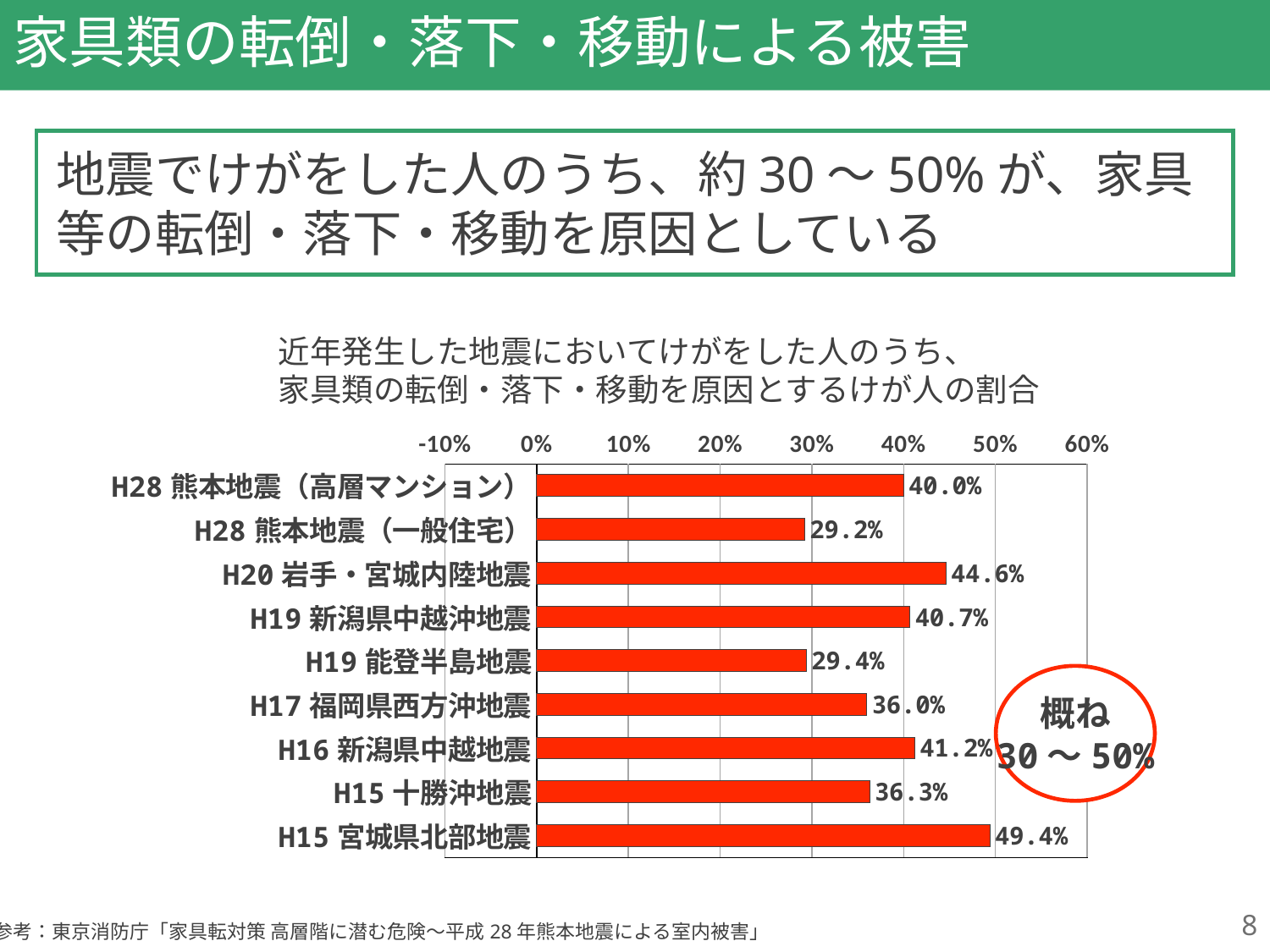
What is the difference between the values for H15 宮城県北部地震 and H28 熊本地震（一般住宅）? 20.2 percentage points Which is larger, the value for H16 新潟県中越地震 or the value for H19 新潟県中越沖地震? H16 新潟県中越地震 What is the value for H28 熊本地震（一般住宅）? 29.2% What is the value for H17 福岡県西方沖地震? 36.0% What is the value for H20 岩手・宮城内陸地震? 44.6% What range is written inside the red circle next to the chart? 概ね30～50% How many earthquakes (categories) are plotted in the chart? 9 Which earthquake has the lowest value in the chart? H28 熊本地震（一般住宅） Which earthquake has the highest value in the chart? H15 宮城県北部地震 What is the value for H15 宮城県北部地震? 49.4% What type of chart is shown on the slide? bar chart Is the value for H15 十勝沖地震 greater or less than 30%? greater